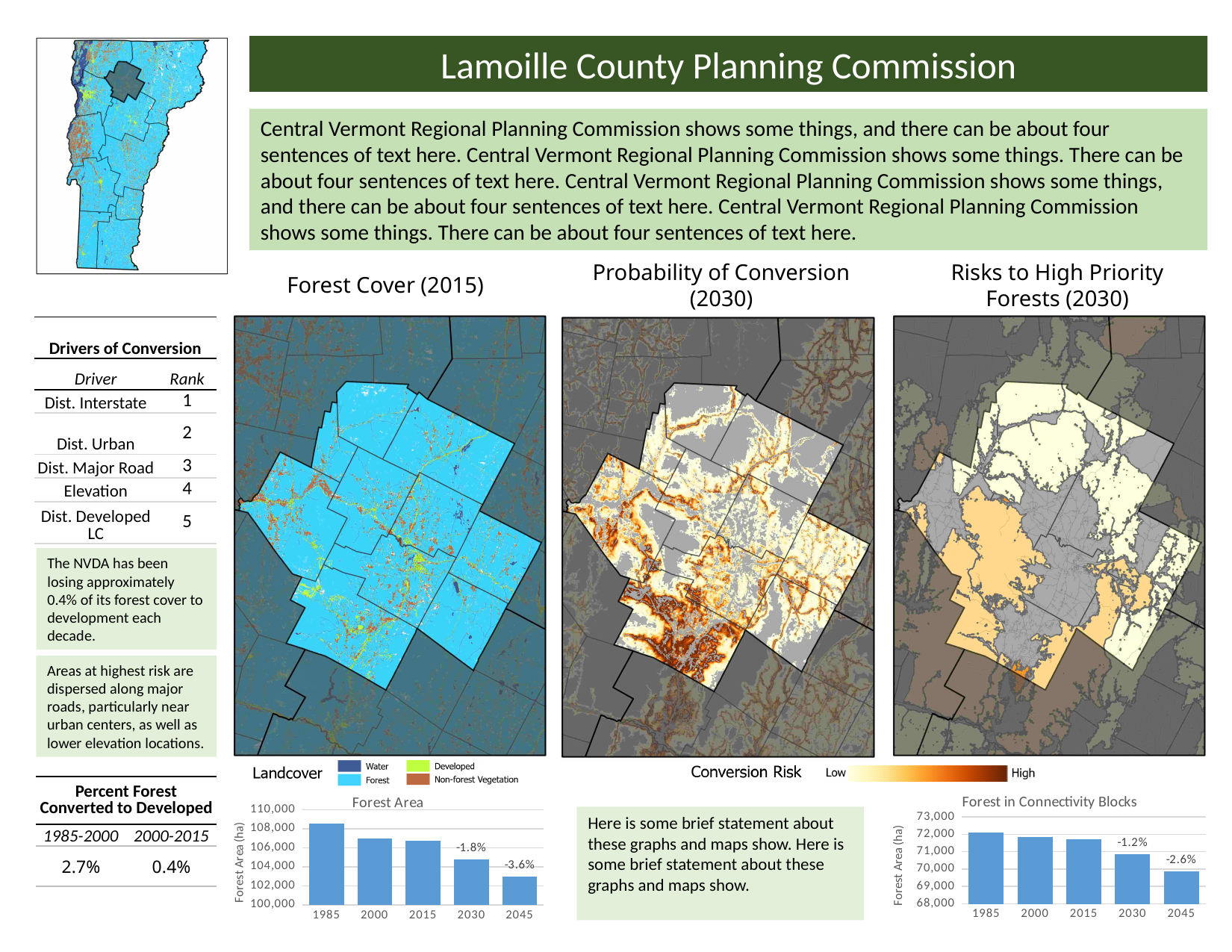
In the Forest in Connectivity Blocks chart, what is the data label shown on the 2030 bar? -1.2% What kind of chart is the Forest in Connectivity Blocks chart? bar chart In the Forest Area chart, do the values rise or fall from 1985 to 2045? fall In the Forest in Connectivity Blocks chart, what is the data label shown on the 2045 bar? -2.6% In the Forest Area chart, what is the data label shown on the 2045 bar? -3.6% In the Forest Area chart, is the value for 1985 greater or less than 106,000? greater In the Forest Area chart, is the value for 2045 greater or less than 104,000? less In the Forest in Connectivity Blocks chart, is the value for 2045 greater or less than 71,000? less In the Forest Area chart, what is the data label shown on the 2030 bar? -1.8% In the Forest in Connectivity Blocks chart, which year has the lowest value? 2045 How many years are shown on the x axis of the Forest Area chart? 5 In the Forest Area chart, which year has the highest forest area? 1985